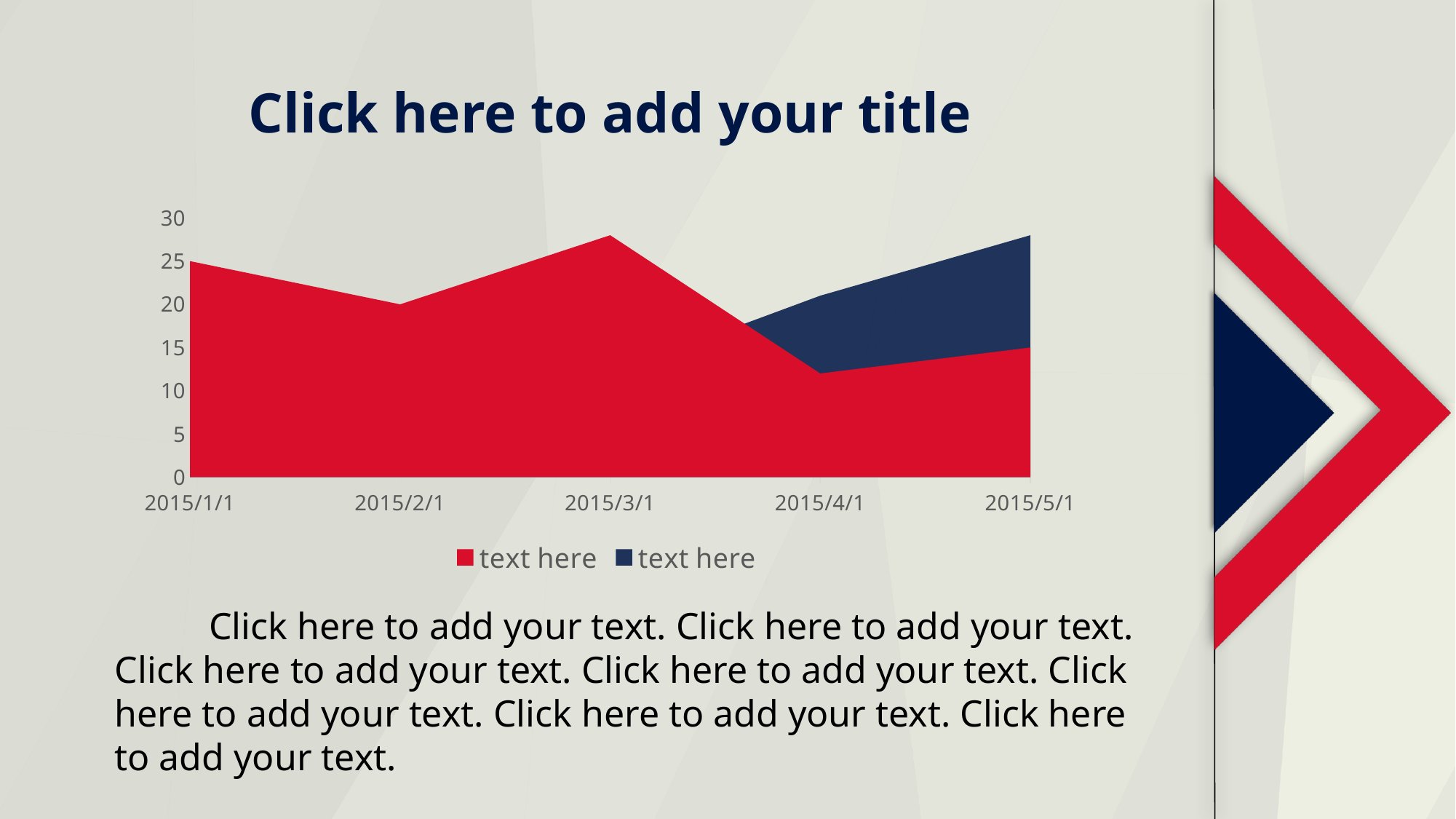
How many series does the chart's legend list? 2 Does the red series rise or fall between 2015/3/1 and 2015/4/1? Fall Is the value of the navy series at 2015/5/1 greater or less than 25? greater At which date does the red series reach its highest value? 2015/3/1 What is the value of the red series at 2015/1/1? 25 What kind of chart is shown on the slide? Area chart What is the first date label on the x axis of the chart? 2015/1/1 Is the value of the red series at 2015/3/1 greater or less than 25? greater How many dates are shown along the x axis of the chart? 5 Which is larger for the red series: the value at 2015/1/1 or the value at 2015/2/1? 2015/1/1 At which date does the red series reach its lowest value? 2015/4/1 Is the value of the red series at 2015/4/1 greater or less than 15? less